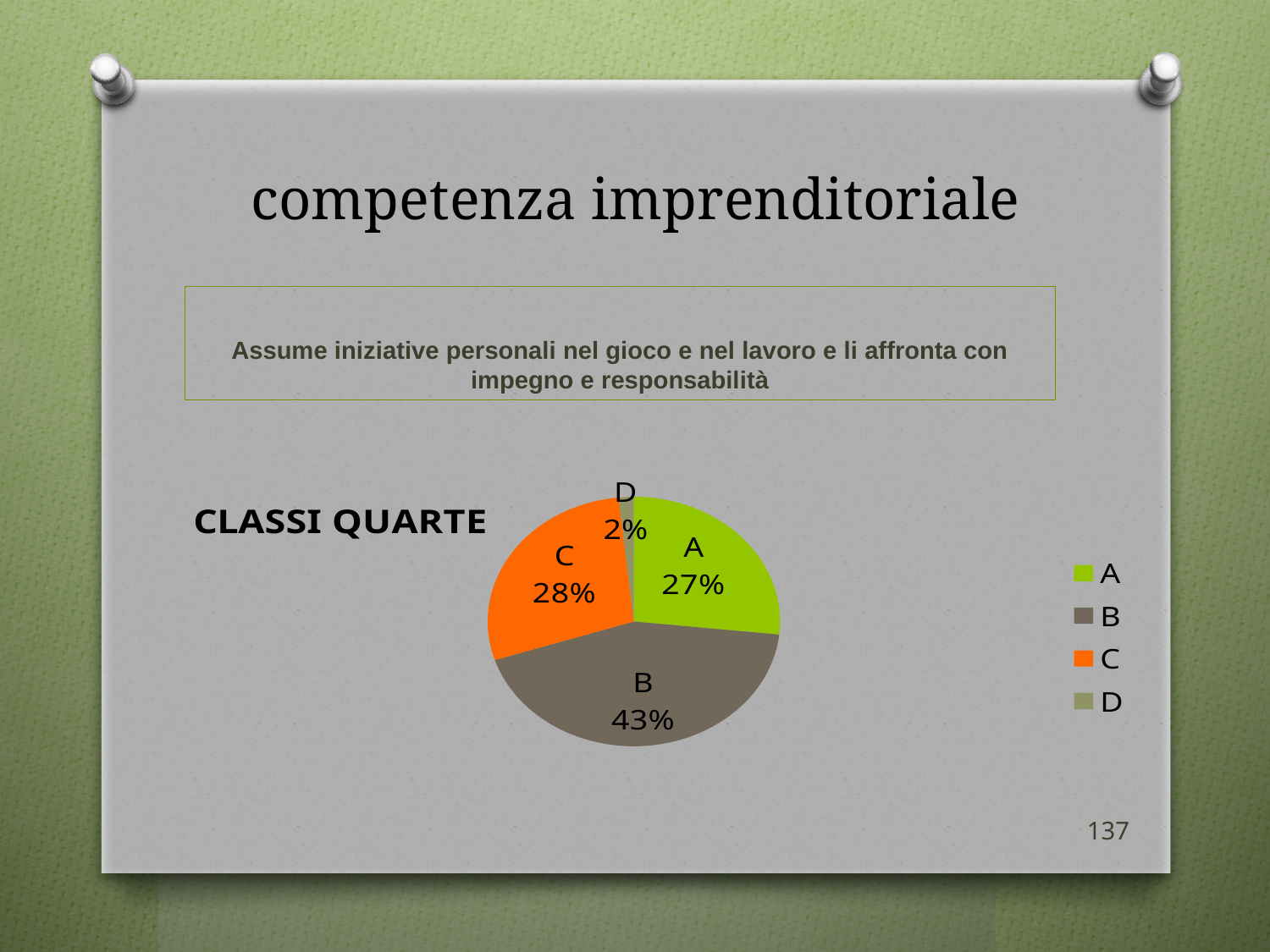
What is the difference in percentage points between slice B and slice A? 16 How many slices does the pie chart have? 4 Which slice of the pie chart is the largest? B What percentage does slice B represent in the pie chart? 43% What percentage does slice A represent in the pie chart? 27% Which is larger, slice B or slice C? B What kind of chart is shown on the slide? pie chart What colour is slice C in the pie chart? orange Which slice of the pie chart is the smallest? D What percentage does slice D represent in the pie chart? 2% How many entries does the legend list? 4 What percentage does slice C represent in the pie chart? 28%